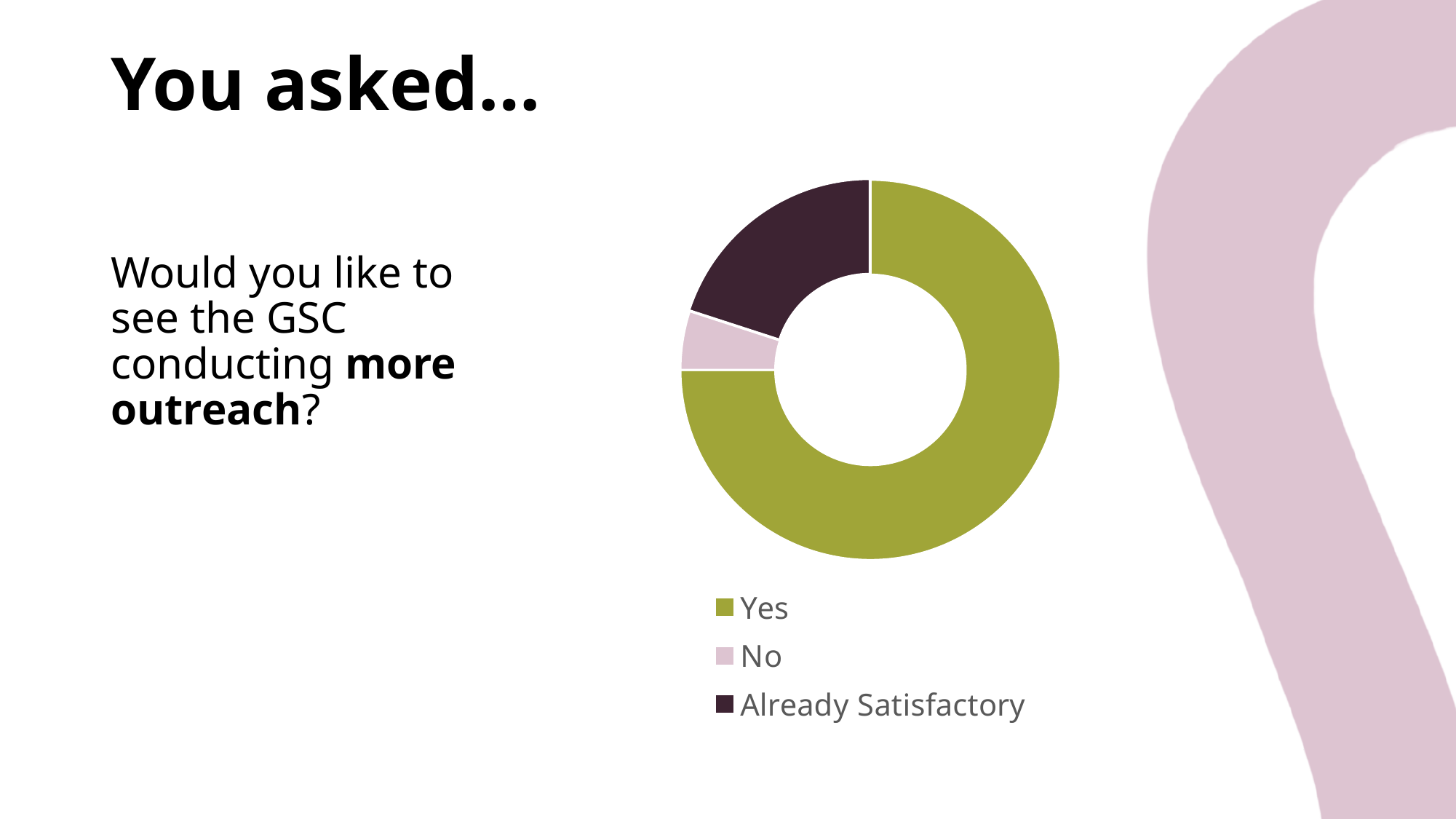
What kind of chart is shown on the slide? Doughnut chart How many categories does the chart show? 3 Which category has the largest share of the chart? Yes Which category has the smallest share of the chart? No What are the three legend entries listed for the chart? Yes, No, Already Satisfactory Which is larger, the share for No or the share for Already Satisfactory? Already Satisfactory Does the Yes category take up more or less than half of the chart? More What colour represents the Yes category in the chart? Green Which is larger, the share for Yes or the share for Already Satisfactory? Yes